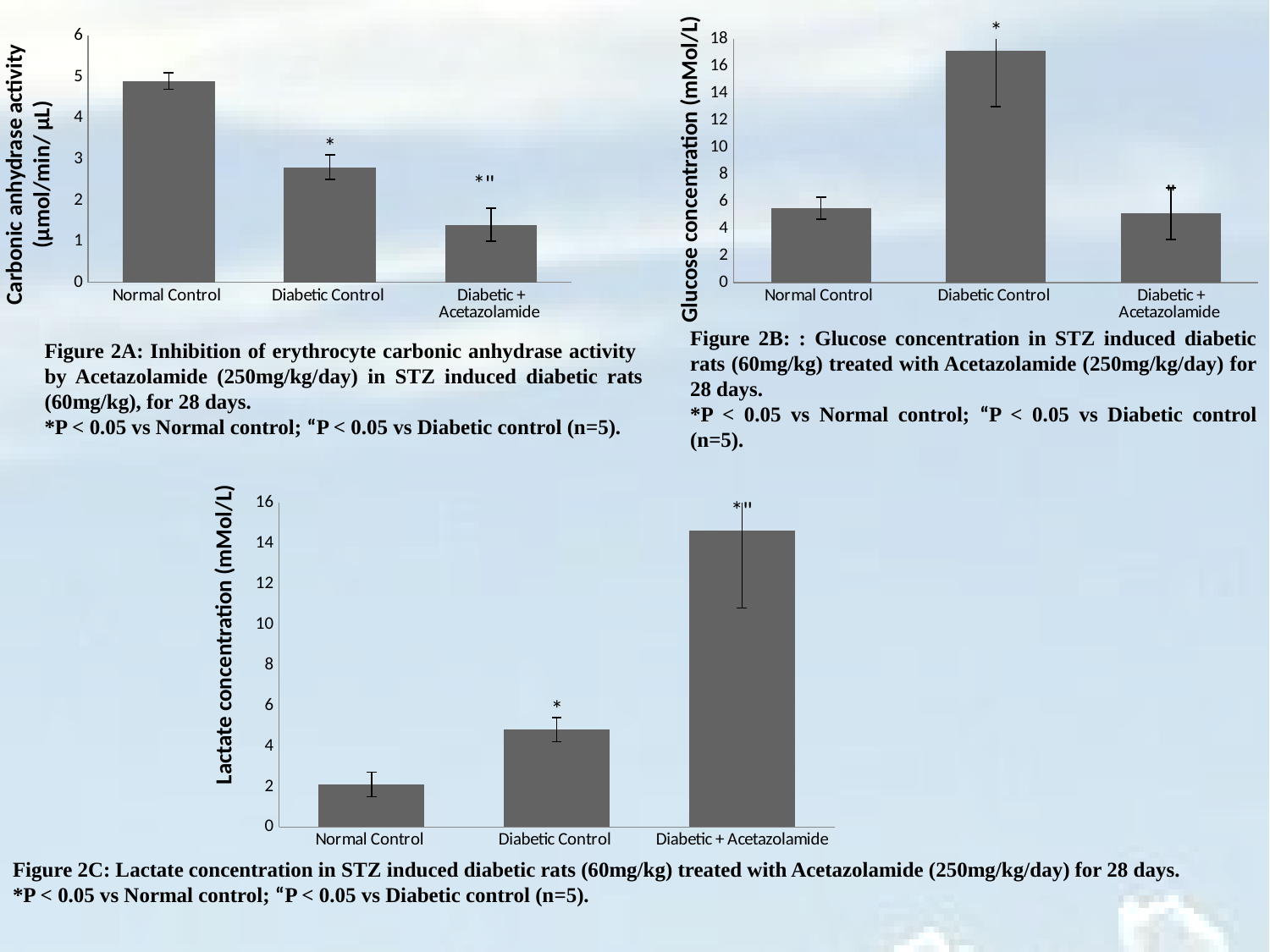
In Figure 2A (carbonic anhydrase activity), is the value for Normal Control greater or less than 4? greater In Figure 2C (lactate concentration), which group has the highest value? Diabetic + Acetazolamide In Figure 2B (glucose concentration), is the value for Normal Control greater or less than 8? less How many groups are shown on the x axis of Figure 2C (lactate concentration)? 3 What kind of chart is Figure 2B (glucose concentration)? bar chart In Figure 2A (carbonic anhydrase activity), which group has the lowest value? Diabetic + Acetazolamide In Figure 2C (lactate concentration), is the value for Diabetic + Acetazolamide greater or less than 14? greater In Figure 2B (glucose concentration), which group has the highest value? Diabetic Control In Figure 2A (carbonic anhydrase activity), which group has the highest value? Normal Control In Figure 2C (lactate concentration), which is larger, Normal Control or Diabetic Control? Diabetic Control